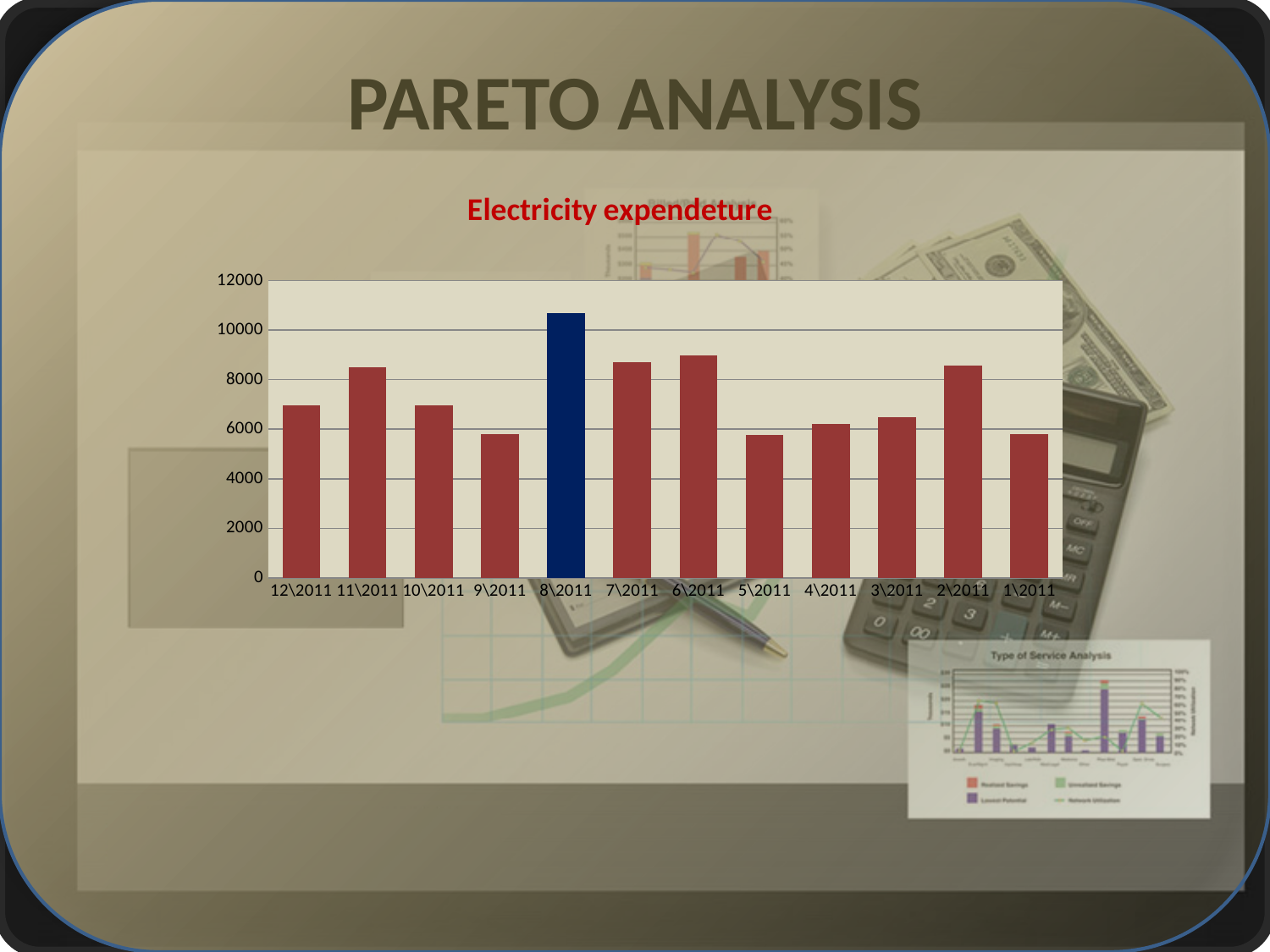
Which is larger, the value for 8\2011 or the value for 7\2011? 8\2011 Which bar is coloured differently (blue) from the others? 8\2011 Which is larger, the value for 11\2011 or the value for 9\2011? 11\2011 What is the title of the chart? Electricity expendeture Which month has the highest electricity expenditure? 8\2011 Is the value for 12\2011 greater or less than 8000? less What kind of chart is shown on the slide? bar chart How many months (categories) are plotted on the x axis? 12 Is the value for 8\2011 greater or less than 10000? greater Is the value for 9\2011 greater or less than 6000? less